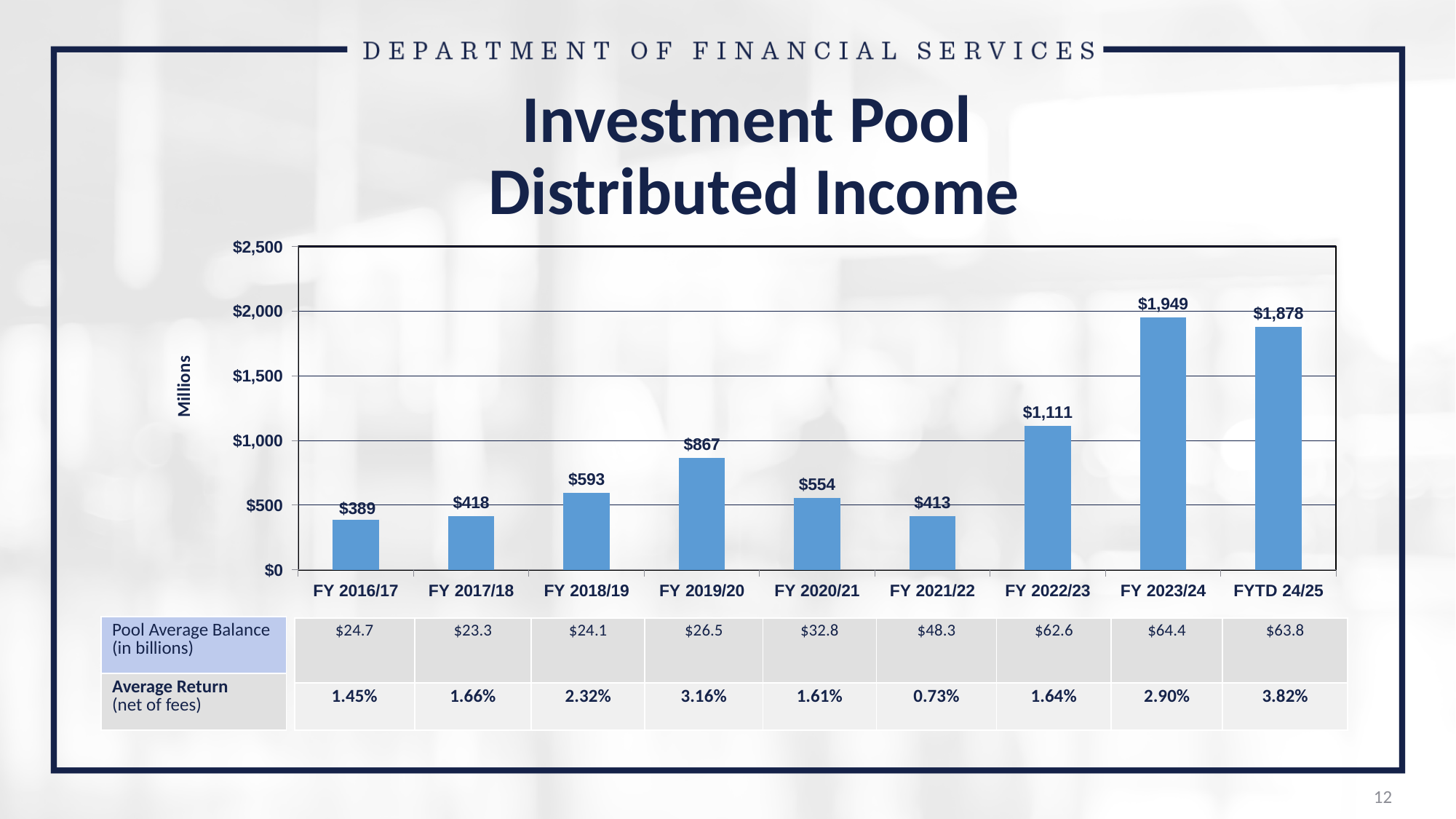
How many fiscal years are shown on the x axis of the chart? 9 What is the title of the slide containing the chart? Investment Pool Distributed Income What kind of chart is shown on the slide? Bar chart What is the difference in distributed income between FY 2023/24 and FYTD 24/25? $71 What is the distributed income for FY 2019/20? $867 What is the label on the vertical axis of the chart? Millions Is the distributed income for FY 2022/23 greater or less than $1,000? greater What is the distributed income for FY 2022/23? $1,111 Which fiscal year has the lowest distributed income? FY 2016/17 Which has a larger distributed income, FY 2018/19 or FY 2020/21? FY 2018/19 Which fiscal year has the highest distributed income? FY 2023/24 Does the distributed income rise or fall from FY 2021/22 to FY 2023/24? Rise